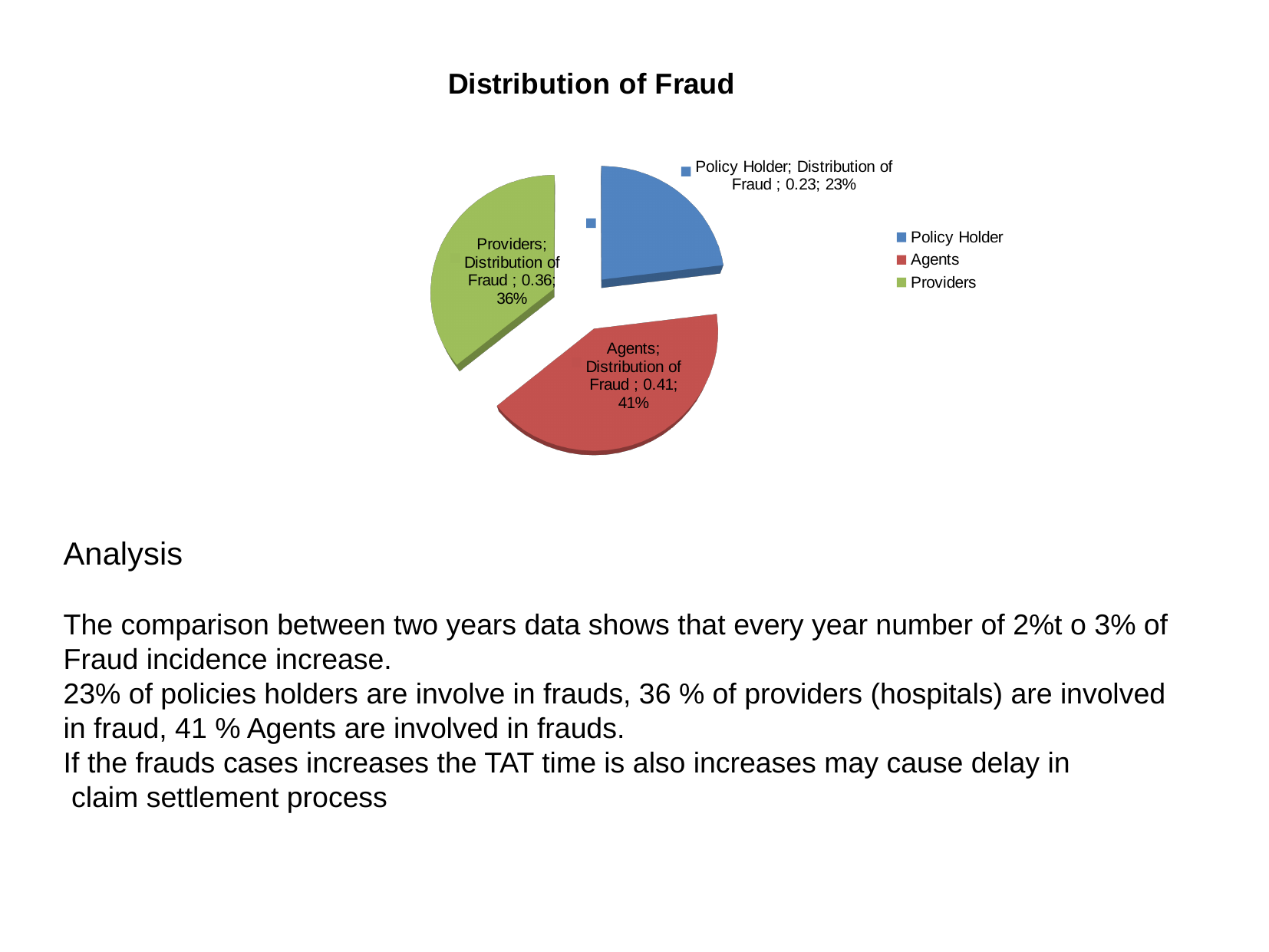
Which colour represents Agents in the legend? Red Which category has the smallest share of the pie? Policy Holder What percentage share of the pie does Agents have? 41% What type of chart is shown on the slide? Pie chart What percentage share of the pie does Policy Holder have? 23% Which category has the largest share of the pie? Agents What is the value shown for Providers in the data label? 0.36 What percentage share of the pie does Providers have? 36% What is the difference in percentage points between the Agents share and the Policy Holder share? 18% What is the title of the chart? Distribution of Fraud Which has a larger share, Providers or Policy Holder? Providers How many categories does the pie chart have? 3